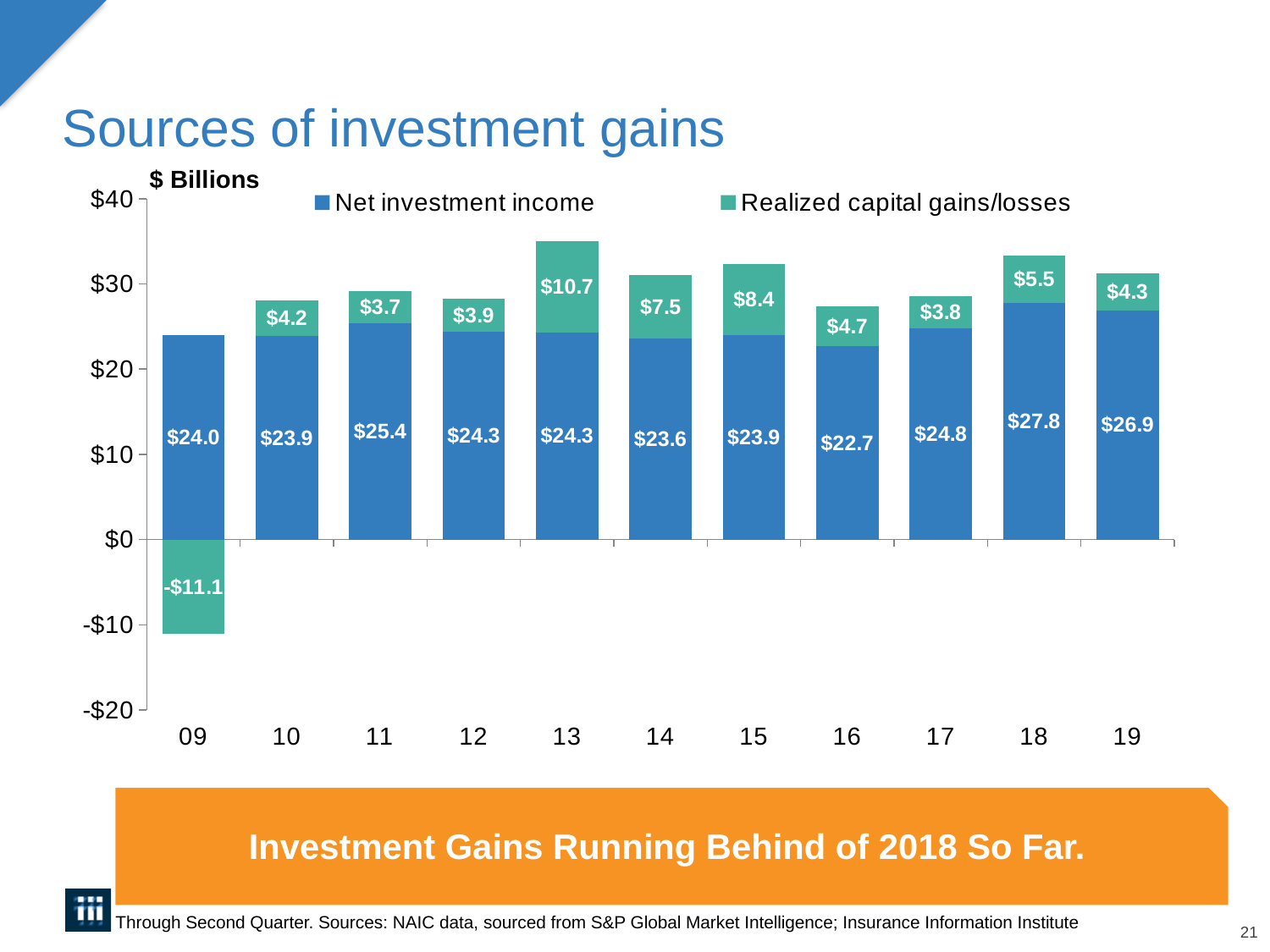
What is the realized capital gains/losses value for 09? -$11.1 What is the total of the stacked bar for 13? $35.0 What is the realized capital gains/losses value for 13? $10.7 What type of chart is shown on the slide? Stacked bar chart Which year has the highest realized capital gains/losses? 13 Which year has the lowest net investment income? 16 What is the difference between net investment income in 18 and in 19? $0.9 What is the net investment income value for 18? $27.8 How many series does the legend list? 2 How many years are shown on the x axis? 11 Which is larger, realized capital gains/losses in 14 or in 15? 15 Which year has the highest net investment income? 18